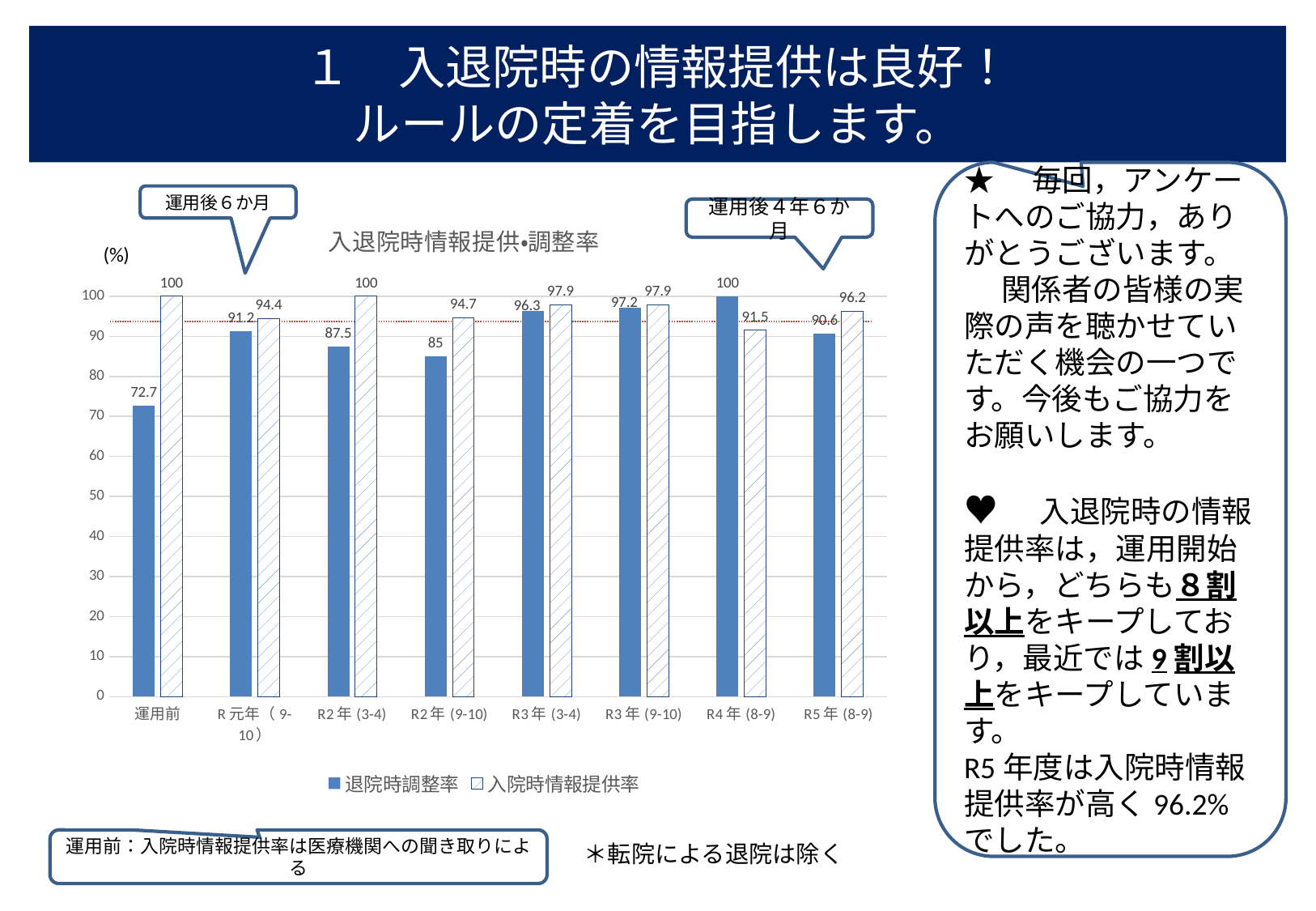
For R2年(9-10), how much higher is 入院時情報提供率 than 退院時調整率? 9.7 For R4年(8-9), which series has the larger value, 退院時調整率 or 入院時情報提供率? 退院時調整率 How many series does the legend list? 2 Which category has the lowest 入院時情報提供率? R4年(8-9) What is the value of 退院時調整率 for 運用前? 72.7 What is the value of 退院時調整率 for R3年(9-10)? 97.2 What is the title of the chart? 入退院時情報提供•調整率 Which category has the lowest 退院時調整率? 運用前 What is the value of 入院時情報提供率 for R5年(8-9)? 96.2 What kind of chart is shown on the slide? Bar chart How many categories are shown on the x axis? 8 Which category has the highest 退院時調整率? R4年(8-9)